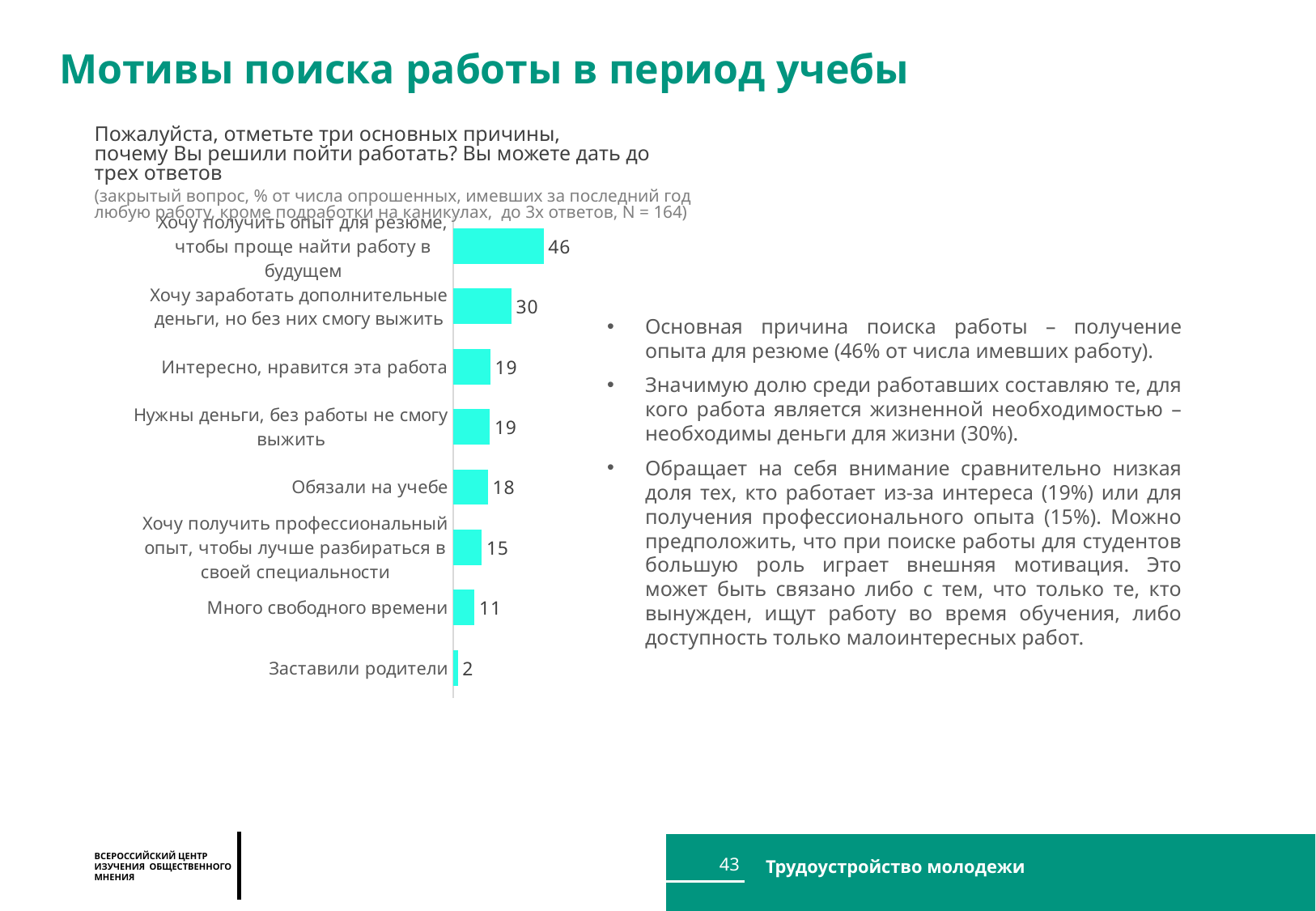
Какой тип диаграммы показан на слайде? Столбчатая (bar chart) Какая категория имеет наибольшее значение на диаграмме? Хочу получить опыт для резюме, чтобы проще найти работу в будущем На сколько значение «Хочу получить опыт для резюме, чтобы проще найти работу в будущем» больше значения «Хочу заработать дополнительные деньги, но без них смогу выжить»? 16 Какое значение у категории «Хочу заработать дополнительные деньги, но без них смогу выжить»? 30 Какое значение у категории «Заставили родители»? 2 Сколько категорий показано на диаграмме? 8 Какая категория имеет наименьшее значение на диаграмме? Заставили родители Какого цвета столбцы на диаграмме? Бирюзового Какое значение у категории «Много свободного времени»? 11 Что больше: значение «Интересно, нравится эта работа» или «Хочу получить профессиональный опыт, чтобы лучше разбираться в своей специальности»? Интересно, нравится эта работа На сколько значение «Обязали на учебе» больше значения «Заставили родители»? 16 Какое значение у категории «Обязали на учебе»? 18